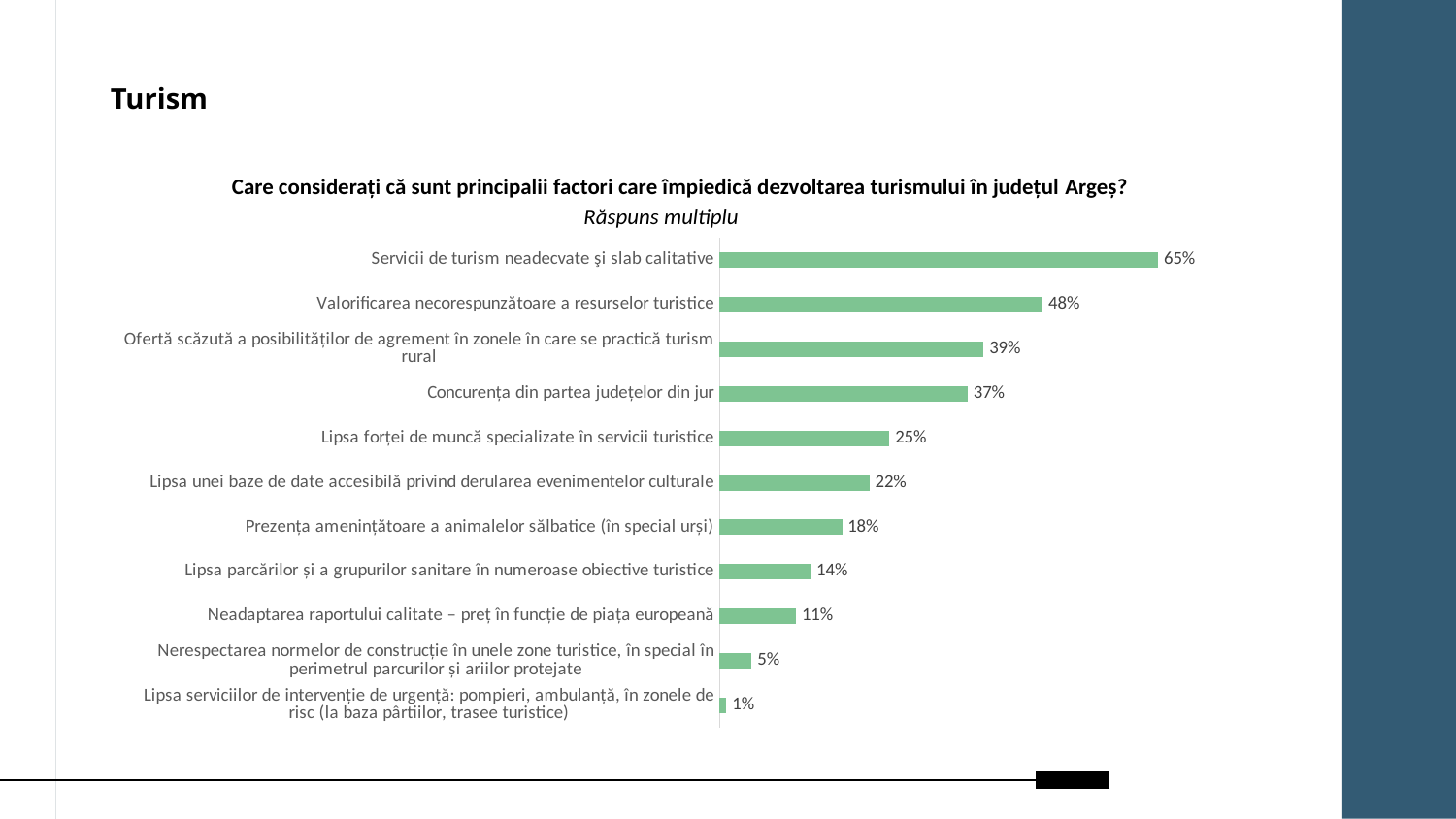
Which has a higher value: "Lipsa unei baze de date accesibilă privind derularea evenimentelor culturale" or "Lipsa parcărilor și a grupurilor sanitare în numeroase obiective turistice"? Lipsa unei baze de date accesibilă privind derularea evenimentelor culturale What is the subtitle shown under the chart's question title? Răspuns multiplu Which factor has the lowest percentage in the chart? Lipsa serviciilor de intervenție de urgență: pompieri, ambulanță, în zonele de risc (la baza pârtiilor, trasee turistice) Which factor has the highest percentage in the chart? Servicii de turism neadecvate și slab calitative How many factors (categories) are shown in the chart? 11 What type of chart is shown on the slide? Bar chart What percentage of respondents cited "Servicii de turism neadecvate și slab calitative" as a factor hindering tourism development? 65% What is the value shown for "Concurența din partea județelor din jur"? 37% What is the difference between the highest and lowest values in the chart? 64 percentage points What is the value for "Nerespectarea normelor de construcție în unele zone turistice, în special în perimetrul parcurilor și ariilor protejate"? 5% What is the difference in percentage points between "Valorificarea necorespunzătoare a resurselor turistice" and "Lipsa forței de muncă specializate în servicii turistice"? 23 percentage points What percentage is shown for "Prezența amenințătoare a animalelor sălbatice (în special urși)"? 18%